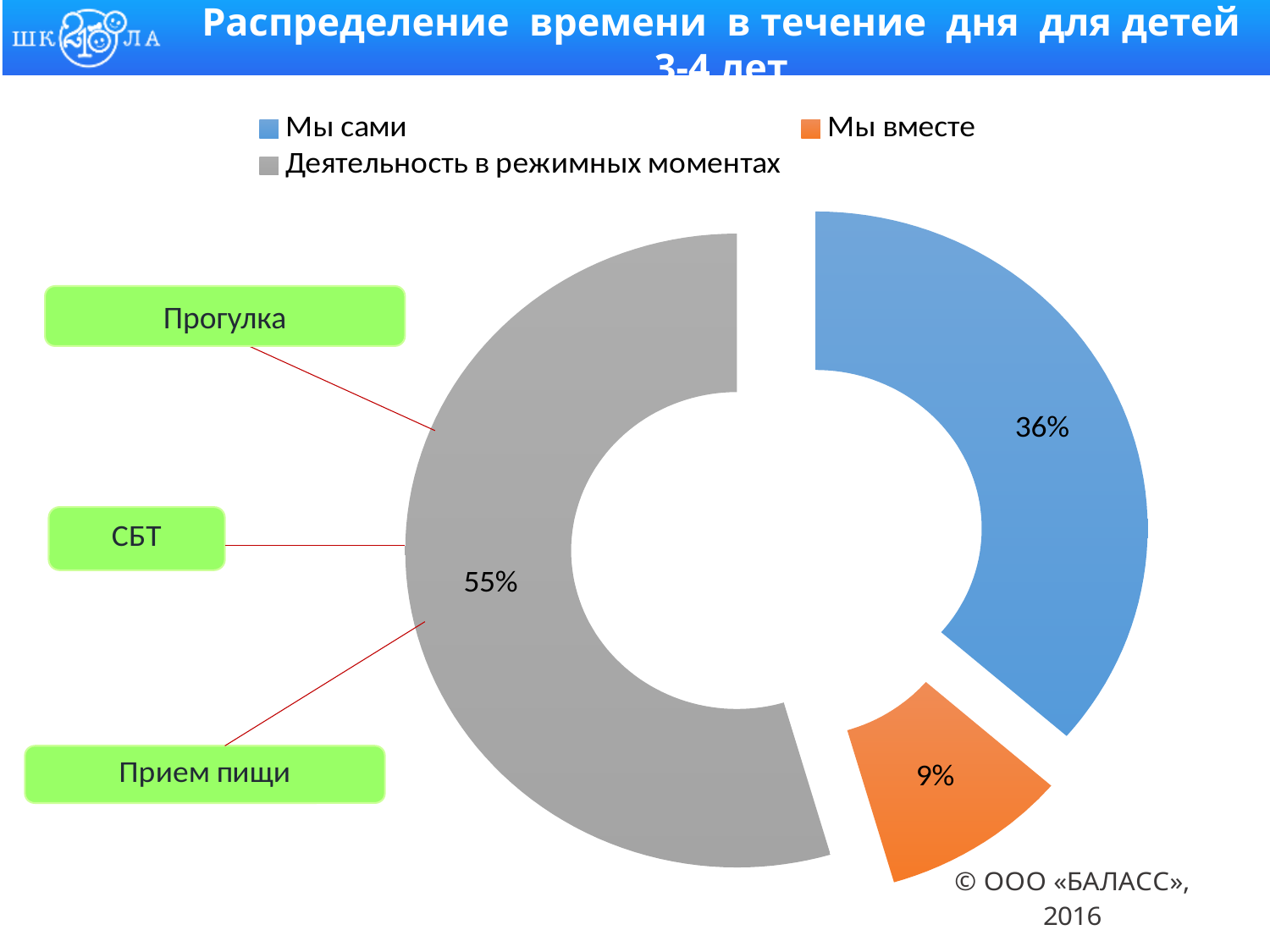
What share of the day is labelled for "Мы сами"? 36% What is the difference in percentage points between "Мы сами" and "Мы вместе"? 27 Which category has the smallest share of the day? Мы вместе Which is larger, the share for "Мы сами" or the share for "Мы вместе"? Мы сами Which category has the largest share of the day? Деятельность в режимных моментах What colour is the segment for "Мы вместе"? Orange How many entries does the legend list? 3 How many segments does the chart have? 3 What share of the day is labelled for "Мы вместе"? 9% What share of the day is labelled for "Деятельность в режимных моментах"? 55% What is the difference in percentage points between "Деятельность в режимных моментах" and "Мы сами"? 19 What kind of chart is shown on the slide? Doughnut (pie) chart